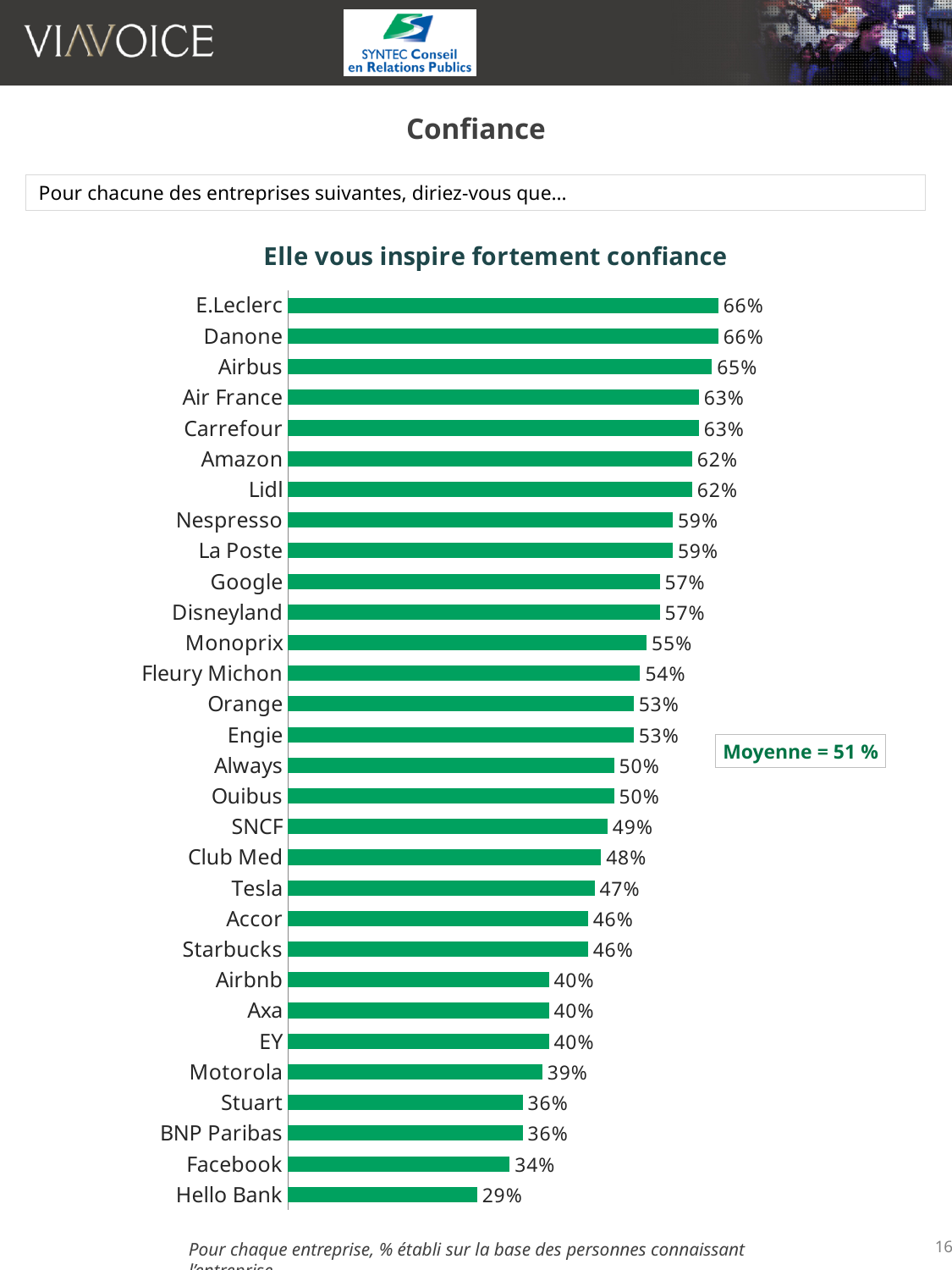
How many companies are listed on the chart? 30 What type of chart is shown on the slide? Bar chart What is the average (Moyenne) value indicated on the chart? 51 % What is the value shown for Facebook? 34% Which company has the lowest value on the chart? Hello Bank What is the title of the chart? Elle vous inspire fortement confiance Which has a higher value, Monoprix or Starbucks? Monoprix What is the difference between the values for Amazon and Tesla? 15 percentage points Which has a higher value, Motorola or Club Med? Club Med What is the difference between the values for Nespresso and Hello Bank? 30 percentage points What percentage of respondents say Airbus strongly inspires confidence? 65% What is the value shown for Fleury Michon? 54%